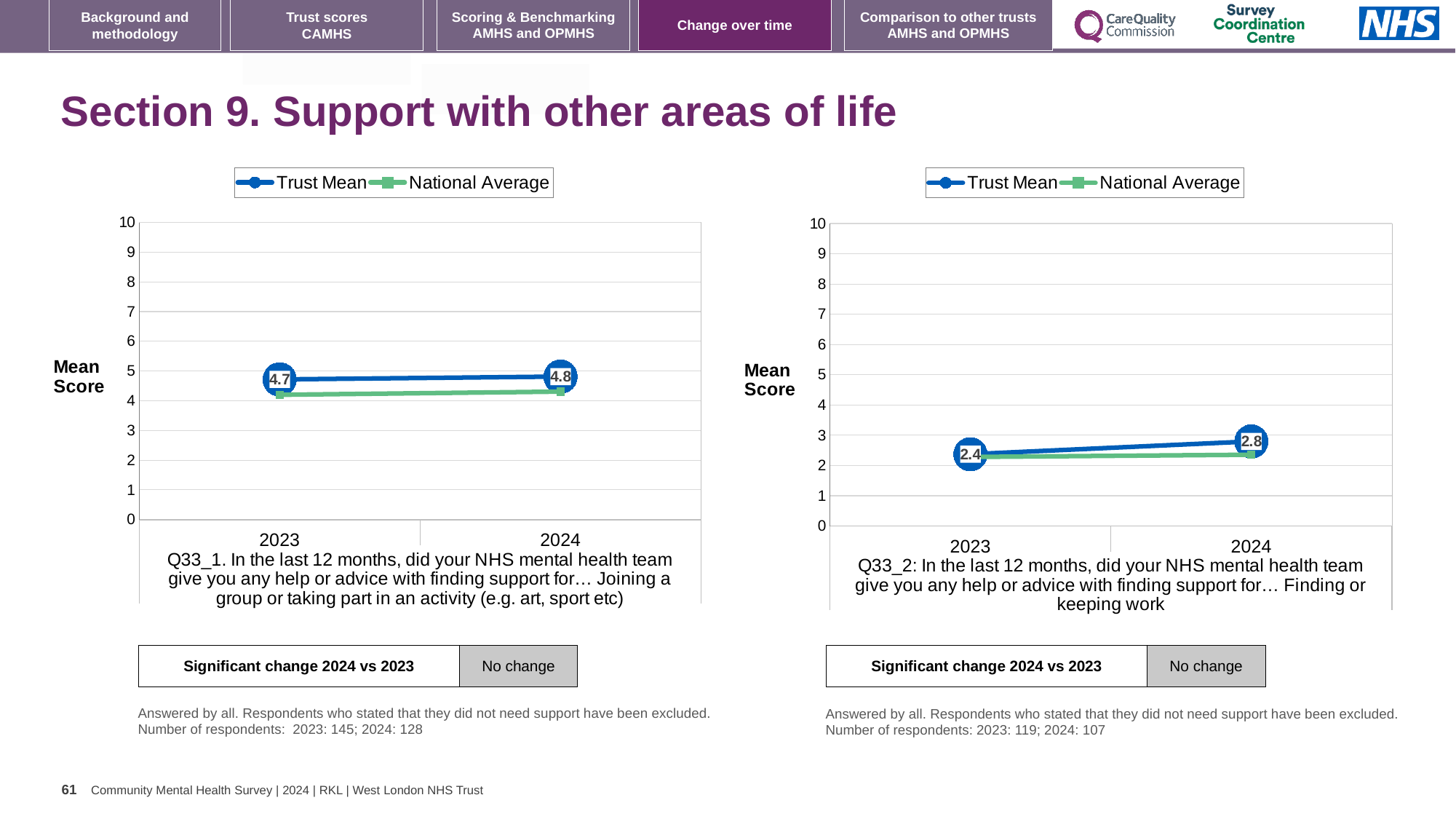
In the left chart (Q33_1), by how much did the Trust Mean change from 2023 to 2024? 0.1 In the left chart (Q33_1), is the National Average value for 2024 greater or less than 5? less How many years are plotted on the x axis of the left chart? 2 What type of chart is used on the left of the slide? line chart In the left chart (Q33_1), what is the Trust Mean score for 2024? 4.8 How many series does the legend of the right chart list? 2 In the right chart (Q33_2), what is the Trust Mean score for 2024? 2.8 In the right chart (Q33_2), which is larger in 2024: the Trust Mean or the National Average? Trust Mean In the left chart (Q33_1), what is the Trust Mean score for 2023? 4.7 In the right chart (Q33_2), what is the Trust Mean score for 2023? 2.4 In the right chart (Q33_2), by how much did the Trust Mean change from 2023 to 2024? 0.4 In the right chart (Q33_2), does the Trust Mean rise or fall from 2023 to 2024? rise